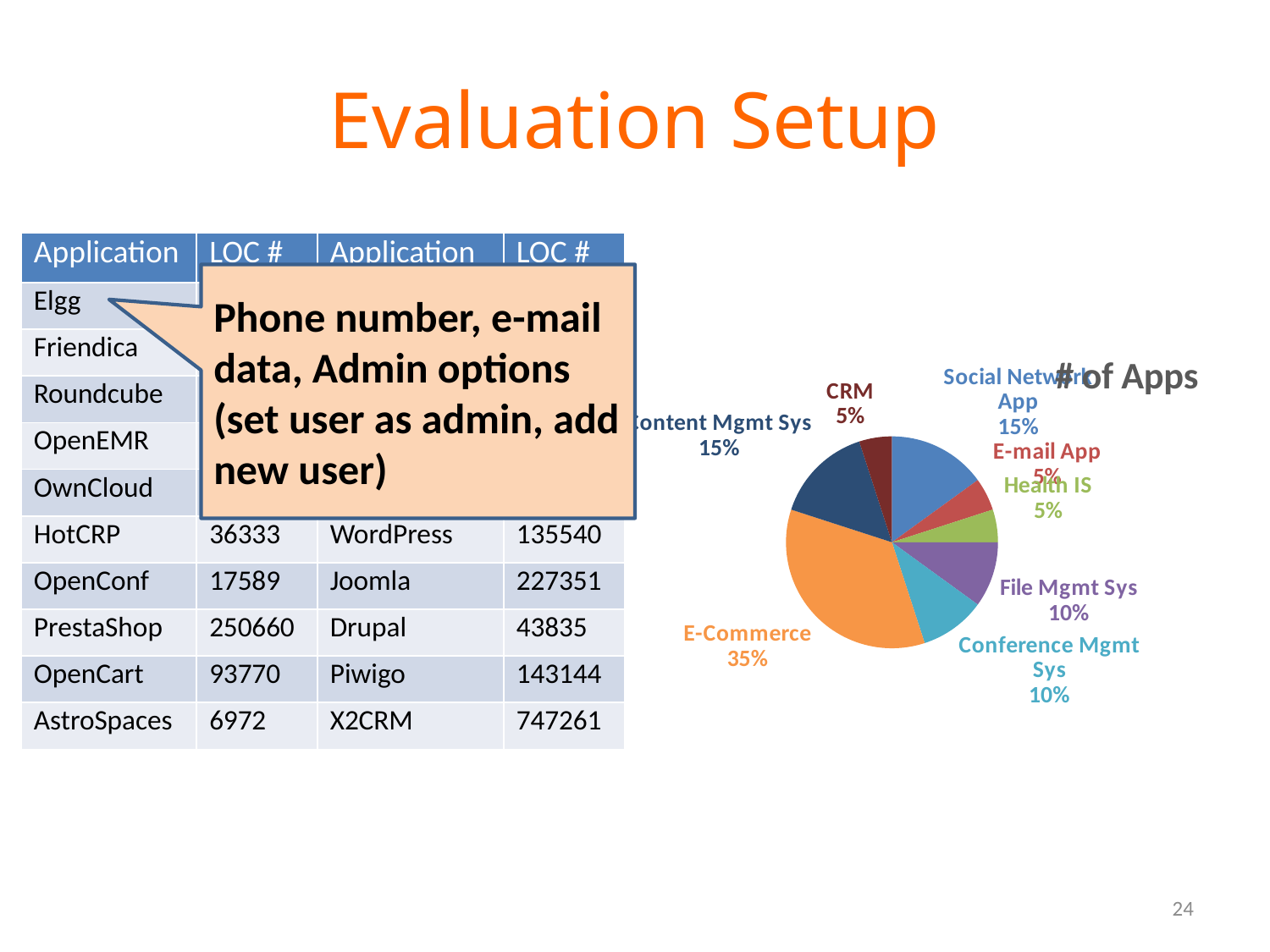
What share of the pie does Conference Mgmt Sys have? 10% What share of the pie does Content Mgmt Sys have? 15% What is the difference between the E-Commerce share and the File Mgmt Sys share? 25% Which category has the largest slice of the pie? E-Commerce How many slices does the pie chart have? 8 What share of the pie does File Mgmt Sys have? 10% What is the title of the pie chart? # of Apps What kind of chart is shown on the slide? pie chart Which is larger, the share for E-Commerce or the share for Content Mgmt Sys? E-Commerce